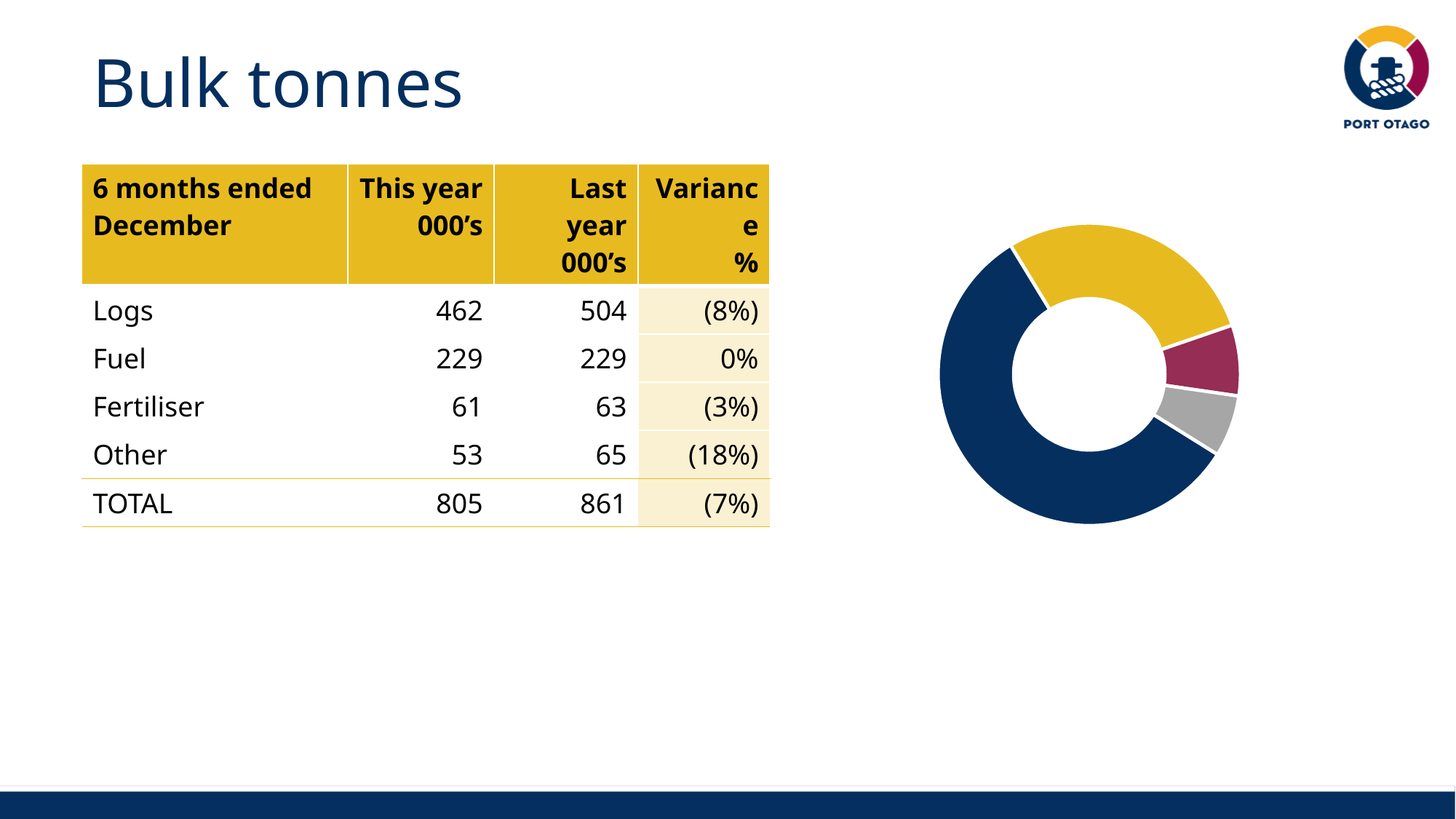
In the donut chart, is the dark blue slice larger or smaller than the yellow slice? Larger Are data labels printed on the slices of the donut chart? No What kind of chart is shown on the right of the slide? Donut chart Does the donut chart include a legend? No How many slices does the donut chart have? 4 Does the dark blue slice take up more or less than half of the donut chart? More Which colour slice is the largest in the donut chart? Dark blue In the donut chart, is the grey slice larger or smaller than the dark blue slice? Smaller In the donut chart, is the yellow slice larger or smaller than the red slice? Larger